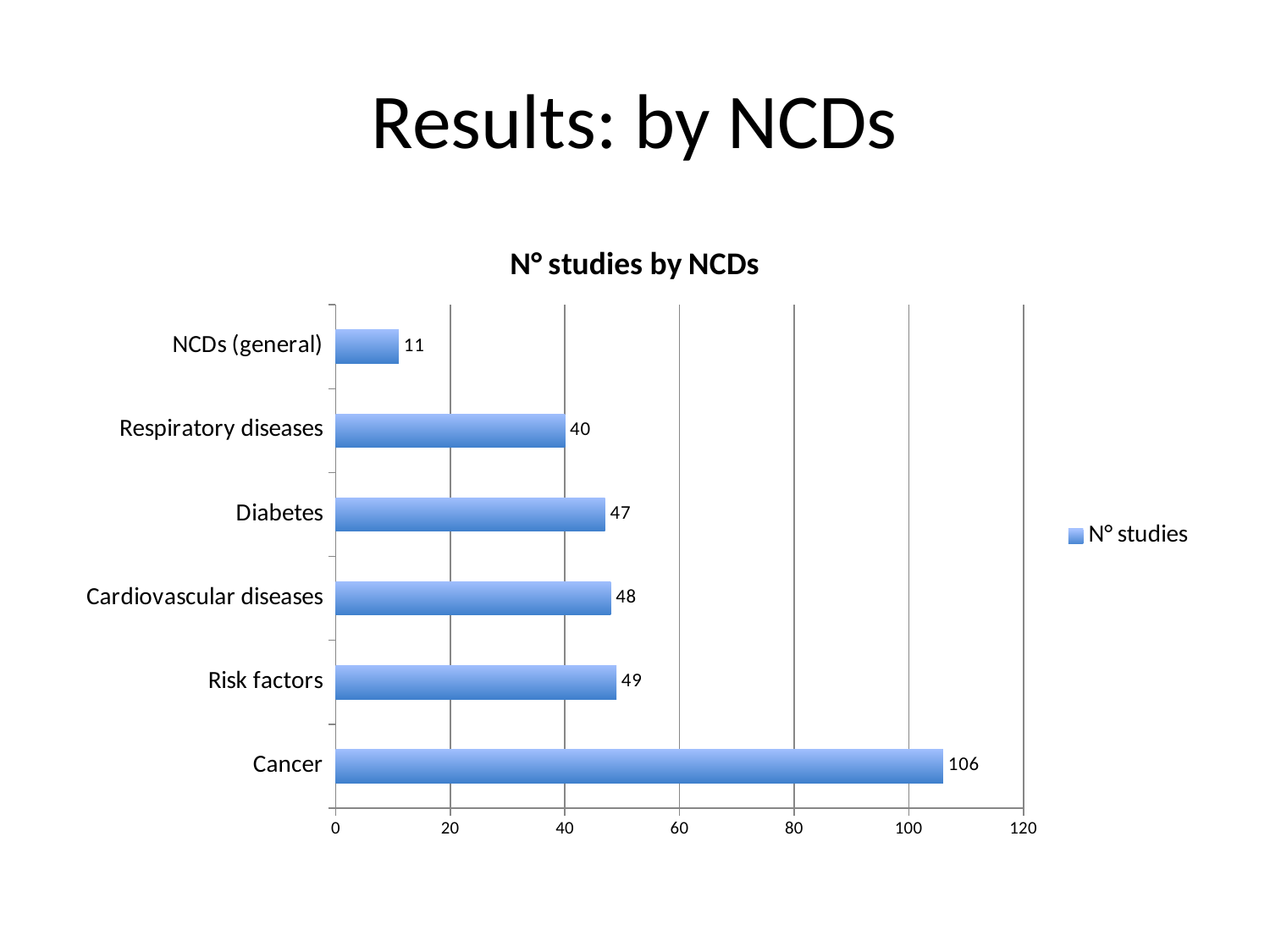
Which category has the lowest number of studies? NCDs (general) How many categories are shown on the chart? 6 What is the number of studies for Respiratory diseases? 40 How many series does the legend list? 1 What is the number of studies for Cancer? 106 Which category has the highest number of studies? Cancer What is the number of studies for NCDs (general)? 11 What kind of chart is shown on the slide? Bar chart What is the title of the chart? N° studies by NCDs What is the difference between the number of studies for Cancer and for Risk factors? 57 Which has more studies, Diabetes or Respiratory diseases? Diabetes Is the value for Cancer greater or less than 100? greater